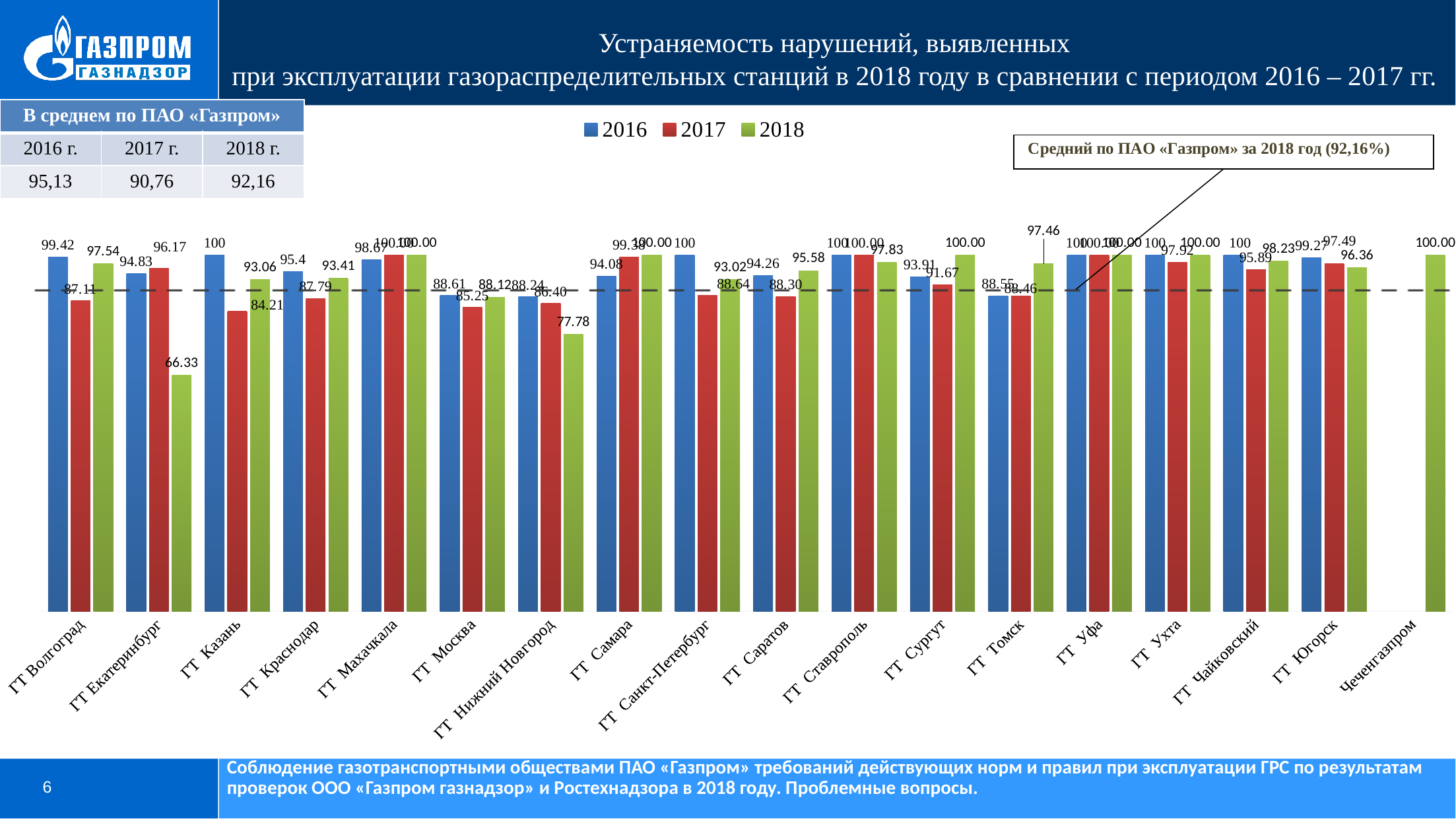
What value does the callout give as the average for ПАО «Газпром» in 2018? 92,16% Which category has the lowest 2017 value? ГТ Казань What is the 2016 value for ГТ Волгоград? 99.42 How many series does the chart legend list? 3 What kind of chart is shown on the slide? bar chart What is the difference between the 2016 and 2017 values for ГТ Волгоград? 12.31 Which is larger for ГТ Томск: the 2016 value or the 2018 value? 2018 What is the 2017 value for ГТ Казань? 84.21 How many categories are shown on the x axis of the chart? 18 What is the 2018 value for ГТ Екатеринбург? 66.33 What is the 2018 value for ГТ Нижний Новгород? 77.78 Which category has the lowest 2018 value? ГТ Екатеринбург